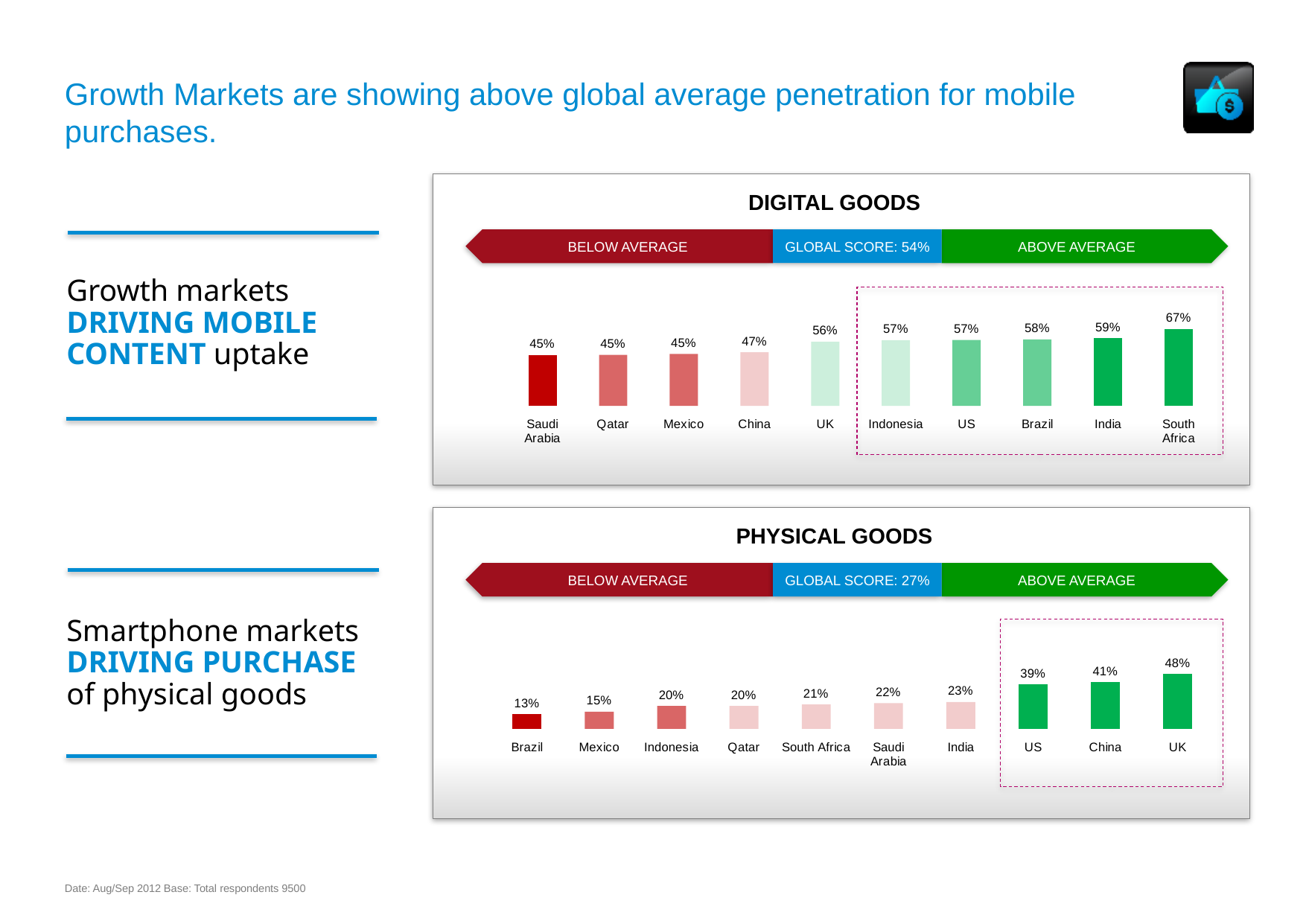
In the DIGITAL GOODS chart, what is the difference between South Africa and India? 8% In the PHYSICAL GOODS chart, which country has the highest value? UK What kind of chart is the PHYSICAL GOODS chart? Bar chart In the PHYSICAL GOODS chart, which is larger, the value for China or the value for US? China In the PHYSICAL GOODS chart, which country has the lowest value? Brazil In the DIGITAL GOODS chart, what is the value for South Africa? 67% In the PHYSICAL GOODS chart, what is the value for Brazil? 13% In the PHYSICAL GOODS chart, what is the difference between the UK and India? 25% In the DIGITAL GOODS chart, which country has the highest value? South Africa In the DIGITAL GOODS chart, what is the global score shown in the banner? 54% In the DIGITAL GOODS chart, how many countries are shown? 10 In the DIGITAL GOODS chart, what is the value for the UK? 56%